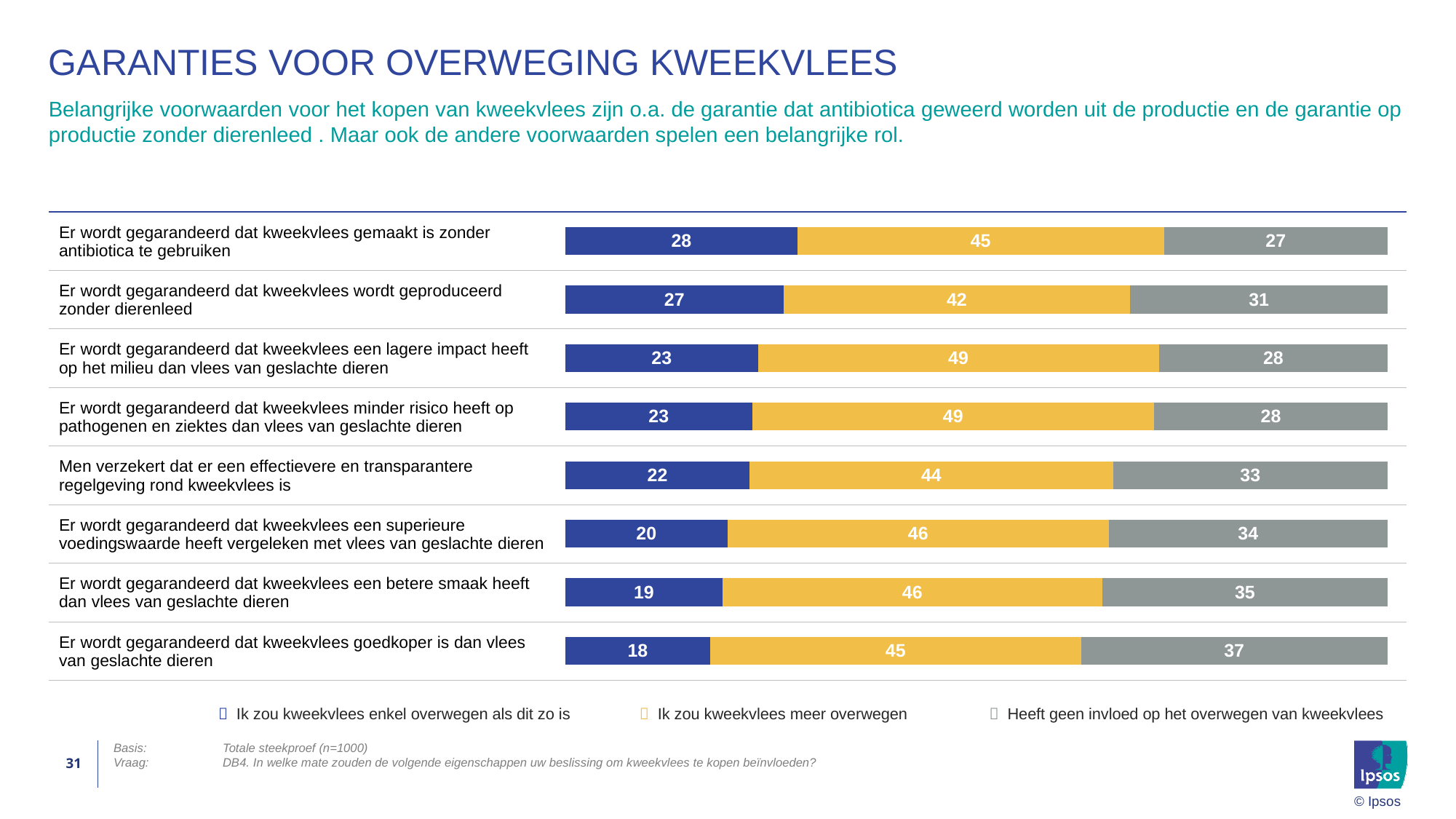
Which statement has the lowest value for 'Ik zou kweekvlees enkel overwegen als dit zo is'? Er wordt gegarandeerd dat kweekvlees goedkoper is dan vlees van geslachte dieren How many series does the legend list? 3 Which statement has the highest value for 'Ik zou kweekvlees enkel overwegen als dit zo is'? Er wordt gegarandeerd dat kweekvlees gemaakt is zonder antibiotica te gebruiken What is the total of the stacked bar for the statement 'Er wordt gegarandeerd dat kweekvlees gemaakt is zonder antibiotica te gebruiken'? 100 Which is larger: the 'Heeft geen invloed op het overwegen van kweekvlees' value for the statement about more effective and transparent regulation (regelgeving) or for the statement about production without antibiotics? The statement about regulation (33) What is the value for 'Ik zou kweekvlees enkel overwegen als dit zo is' for the statement 'Er wordt gegarandeerd dat kweekvlees gemaakt is zonder antibiotica te gebruiken'? 28 What is the difference between the 'Ik zou kweekvlees meer overwegen' values for the statement about a lower impact on the environment (lagere impact op het milieu) and the statement about production without animal suffering (zonder dierenleed)? 7 What is the value for 'Heeft geen invloed op het overwegen van kweekvlees' for the statement 'Er wordt gegarandeerd dat kweekvlees goedkoper is dan vlees van geslachte dieren'? 37 How many statements (categories) are shown in the chart? 8 Which statement has the highest value for 'Heeft geen invloed op het overwegen van kweekvlees'? Er wordt gegarandeerd dat kweekvlees goedkoper is dan vlees van geslachte dieren What kind of chart is shown on the slide? Stacked horizontal bar chart What is the value for 'Ik zou kweekvlees meer overwegen' for the statement 'Er wordt gegarandeerd dat kweekvlees wordt geproduceerd zonder dierenleed'? 42